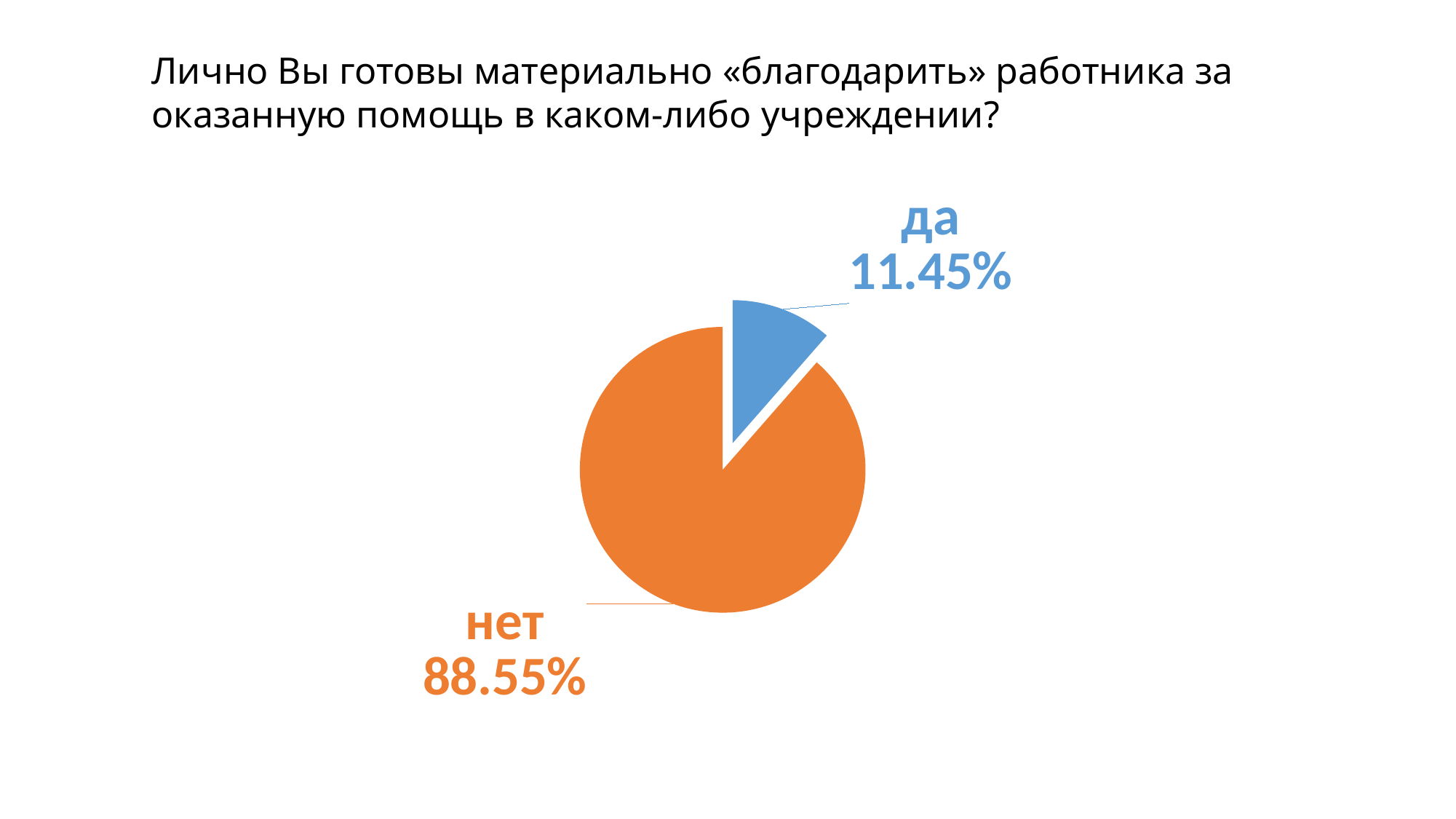
What colour is the "нет" slice? orange Which is larger, the "да" slice or the "нет" slice? нет What colour is the "да" slice? blue What is the difference in percentage points between the "нет" and "да" slices? 77.10% What kind of chart is shown on the slide? pie chart Is the share for "да" greater or less than 50%? less Which slice is the smallest? да Which slice is the largest? нет What share of the pie does the "нет" slice represent? 88.55% How many slices does the pie chart have? 2 What share of the pie does the "да" slice represent? 11.45%